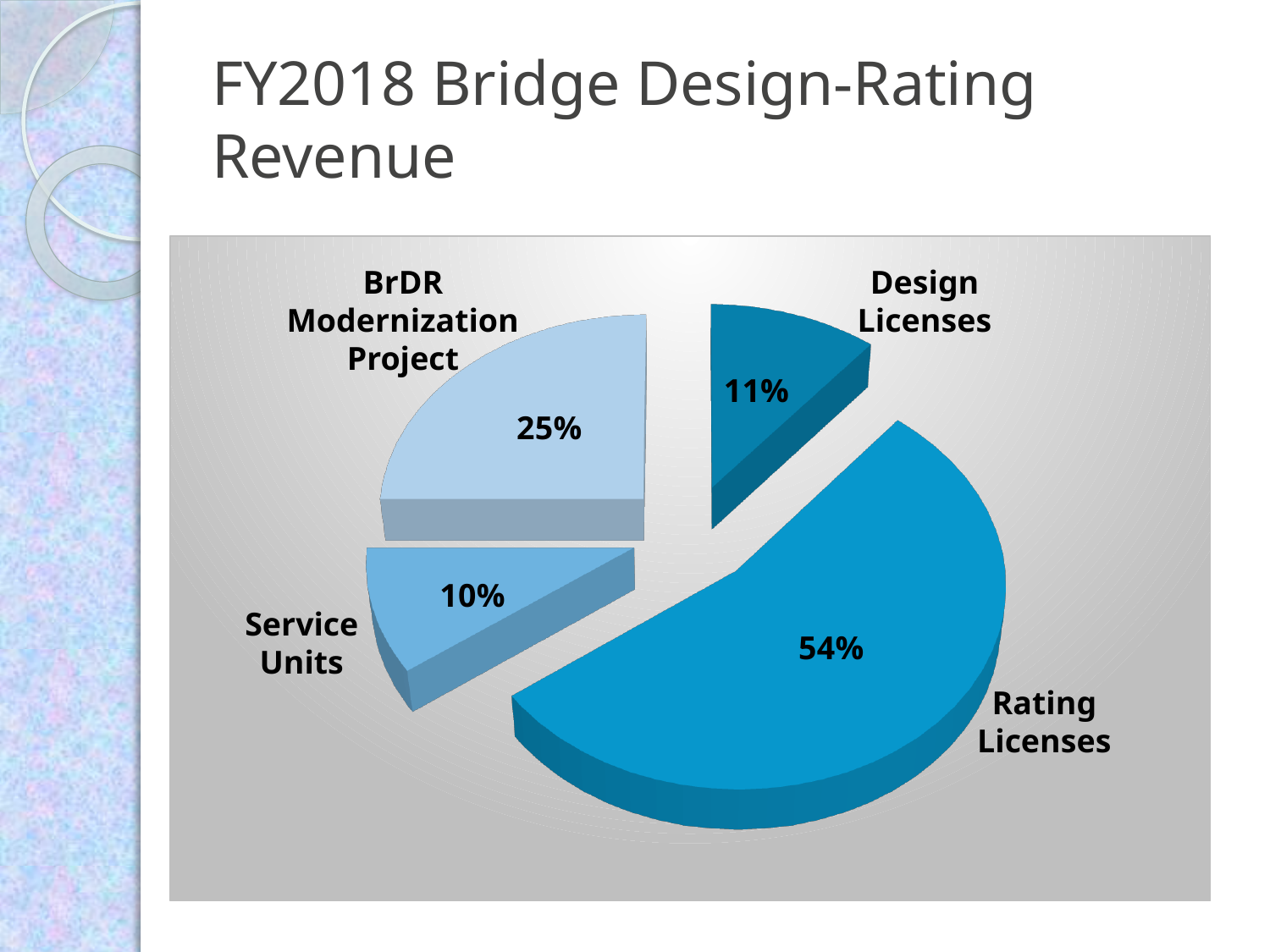
What share of revenue comes from Design Licenses? 11% What share of revenue comes from the BrDR Modernization Project? 25% What is the difference in percentage points between Rating Licenses and the BrDR Modernization Project? 29 What share of revenue comes from Rating Licenses? 54% Which is larger, the share for Design Licenses or the share for the BrDR Modernization Project? BrDR Modernization Project What is the combined share of Design Licenses and Rating Licenses? 65% How many categories are shown in the pie chart? 4 What kind of chart is shown on the slide? Pie chart Which category has the smallest share of revenue? Service Units Which category has the largest share of revenue? Rating Licenses What share of revenue comes from Service Units? 10% What is the title of the slide containing the chart? FY2018 Bridge Design-Rating Revenue